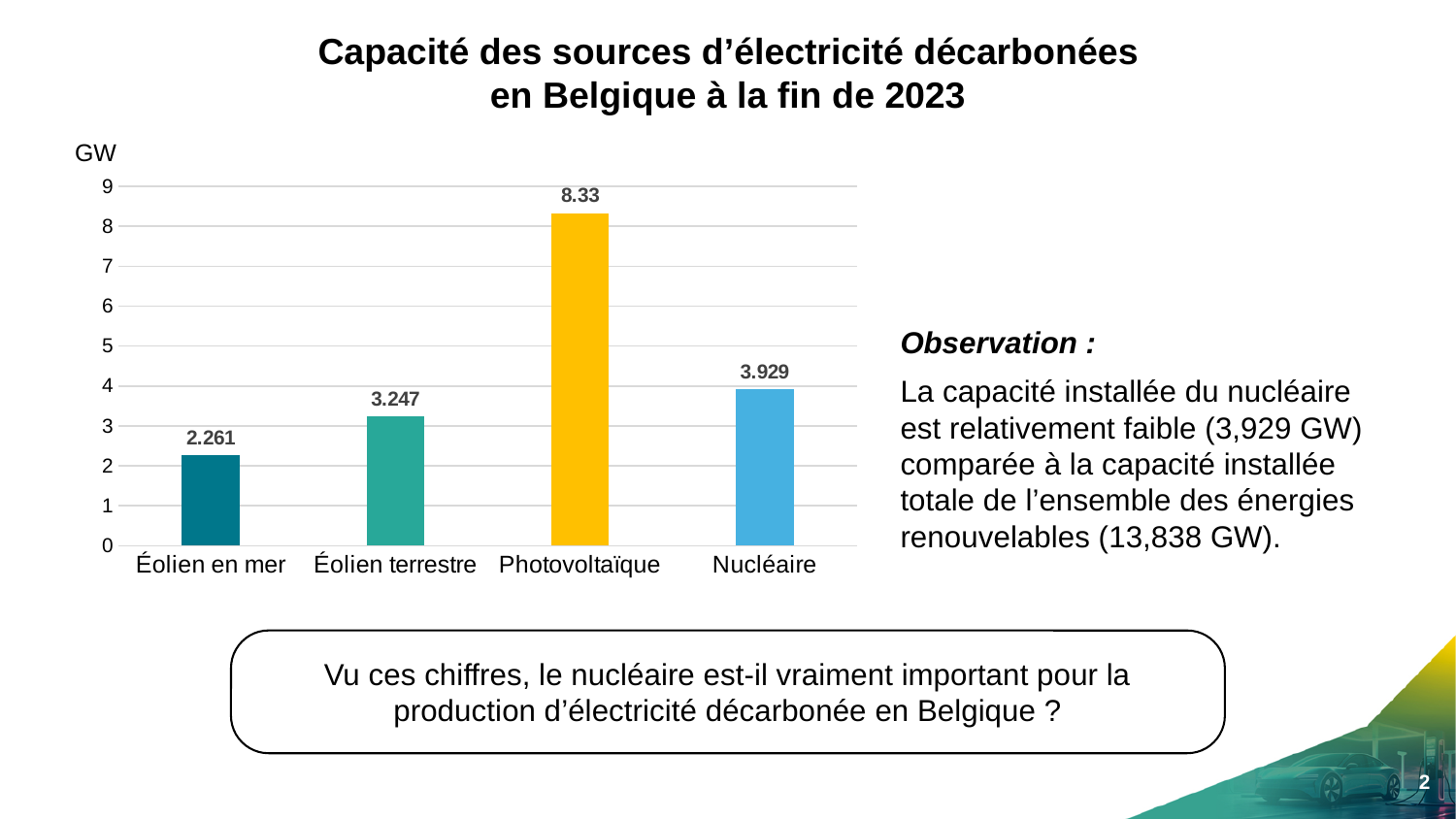
What kind of chart is shown on the slide? Bar chart What unit is shown on the y axis of the chart? GW Which is larger, the value for Nucléaire or the value for Éolien terrestre? Nucléaire Which category has the highest value? Photovoltaïque How many categories are shown on the x axis? 4 What is the value for Photovoltaïque? 8.33 Which category has the lowest value? Éolien en mer What is the difference between the values for Nucléaire and Éolien terrestre? 0.682 What is the value for Nucléaire? 3.929 What is the difference between the values for Photovoltaïque and Nucléaire? 4.401 What is the value for Éolien terrestre? 3.247 What is the value for Éolien en mer? 2.261